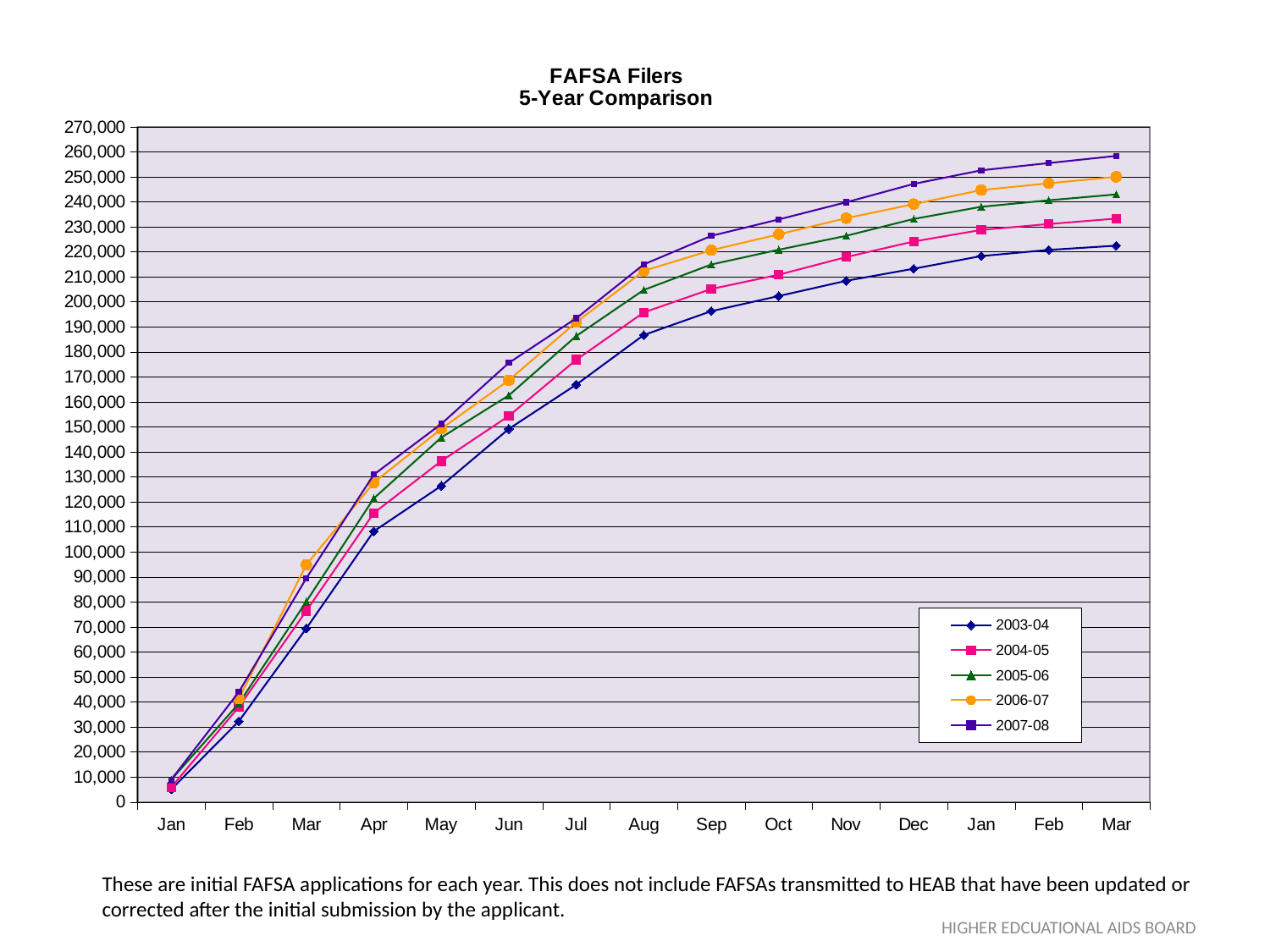
Do the values for each series rise or fall from Jan to the final Mar? rise Is the value for 2007-08 in Aug greater or less than 200,000? greater What is the title of the chart? FAFSA Filers 5-Year Comparison Is the value for 2003-04 at the final Mar greater or less than 200,000? greater How many series does the legend list? 5 Is the value for 2003-04 in Apr greater or less than 100,000? greater Which series has the highest value at the final Mar point? 2007-08 What kind of chart is shown on the slide? line chart Which series has the lowest value at the final Mar point? 2003-04 How many months are shown along the x axis? 15 In Dec, which series has the larger value, 2007-08 or 2003-04? 2007-08